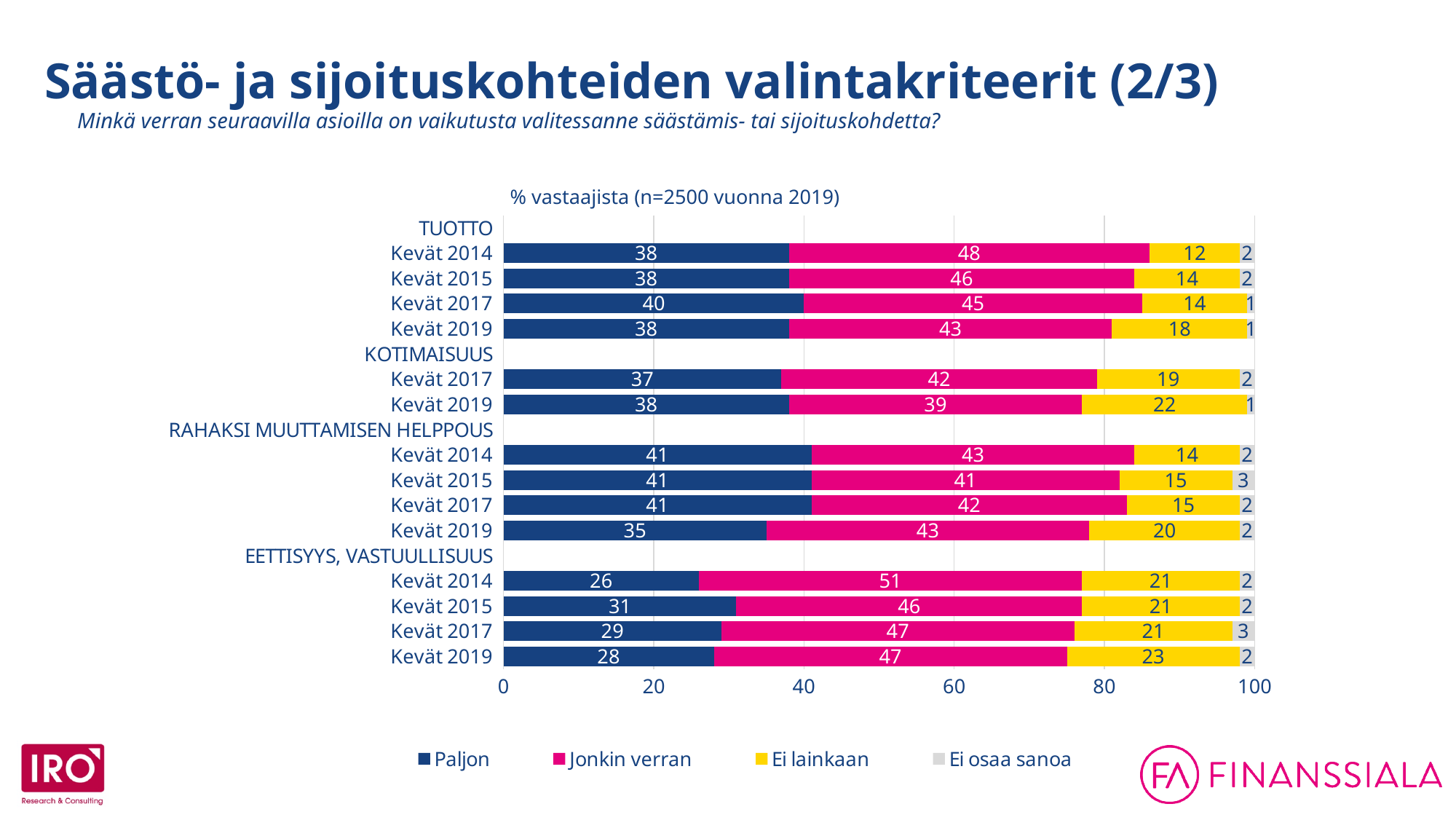
What is the total of the 'Paljon' and 'Jonkin verran' values for Kevät 2019 under KOTIMAISUUS? 77 How many bars are shown under EETTISYYS, VASTUULLISUUS? 4 Which bar has the highest 'Jonkin verran' value? Kevät 2014 under EETTISYYS, VASTUULLISUUS Under RAHAKSI MUUTTAMISEN HELPPOUS, is the 'Paljon' value larger for Kevät 2017 or Kevät 2019? Kevät 2017 Which colour represents 'Ei lainkaan' in the chart? Yellow What is the 'Paljon' value for Kevät 2019 under EETTISYYS, VASTUULLISUUS? 28 What kind of chart is shown on the slide? Stacked bar chart What is the difference between the 'Ei lainkaan' values for Kevät 2014 and Kevät 2019 under TUOTTO? 6 Which bar has the lowest 'Paljon' value? Kevät 2014 under EETTISYYS, VASTUULLISUUS How many series does the legend list? 4 What is the 'Jonkin verran' value for Kevät 2014 under TUOTTO? 48 What is the 'Ei lainkaan' value for Kevät 2019 under KOTIMAISUUS? 22